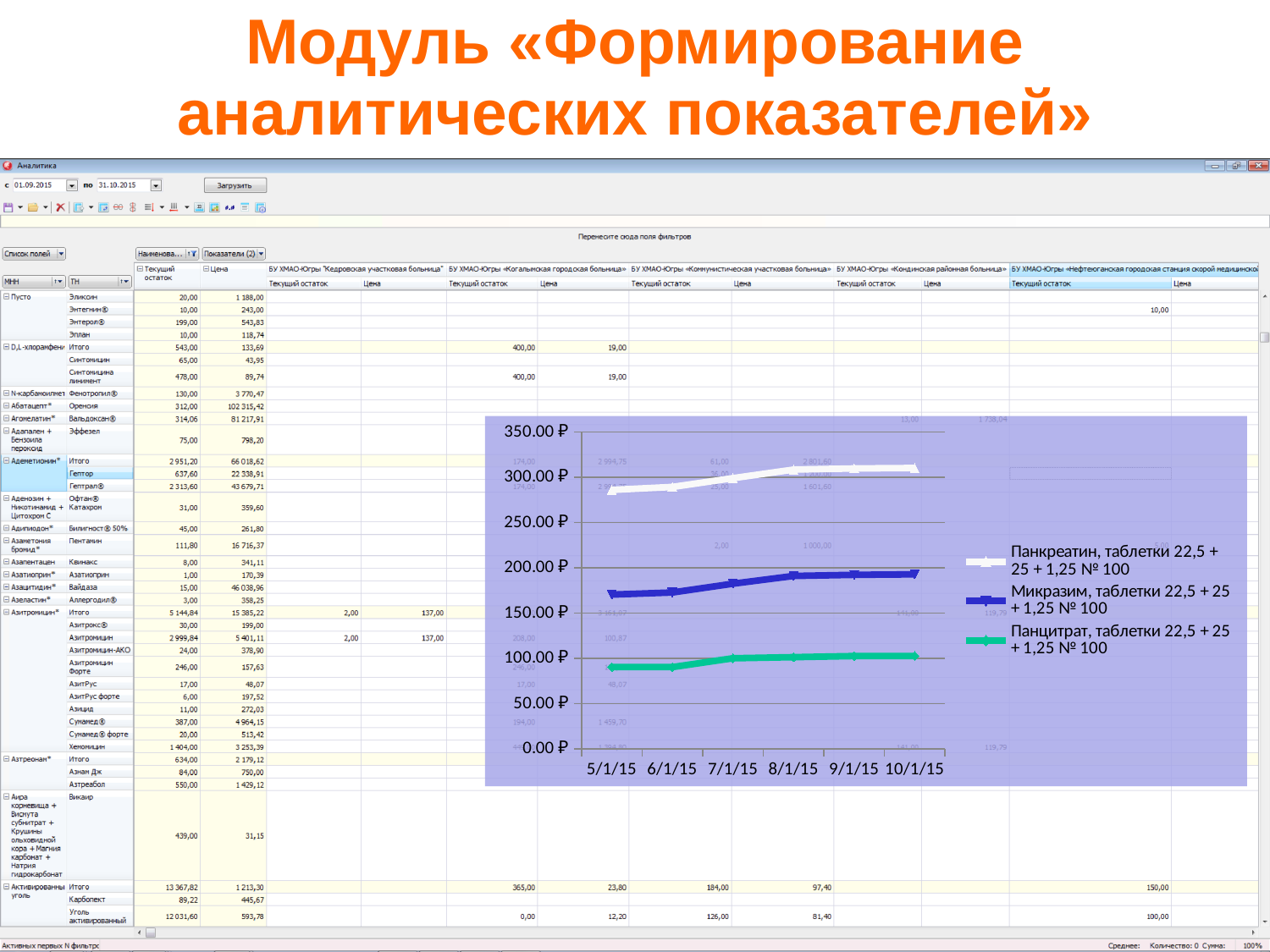
How many series does the chart legend list? 3 What is the first date label on the x axis of the chart? 5/1/15 How many dates are shown along the x axis of the chart? 6 Which series has the highest values on the chart? Панкреатин, таблетки 22,5 + 25 + 1,25 № 100 Do the values for Панцитрат rise or fall from 5/1/15 to 10/1/15? rise Is the value for Микразим at 10/1/15 greater or less than 150.00 ₽? greater Which series has the lowest values on the chart? Панцитрат, таблетки 22,5 + 25 + 1,25 № 100 At 8/1/15, which is larger: the value for Микразим or the value for Панцитрат? Микразим Is the value for Панцитрат at 5/1/15 greater or less than 150.00 ₽? less What kind of chart is shown on the slide? line chart Is the value for Панкреатин at 5/1/15 greater or less than 250.00 ₽? greater What is the highest tick label on the y axis of the chart? 350.00 ₽